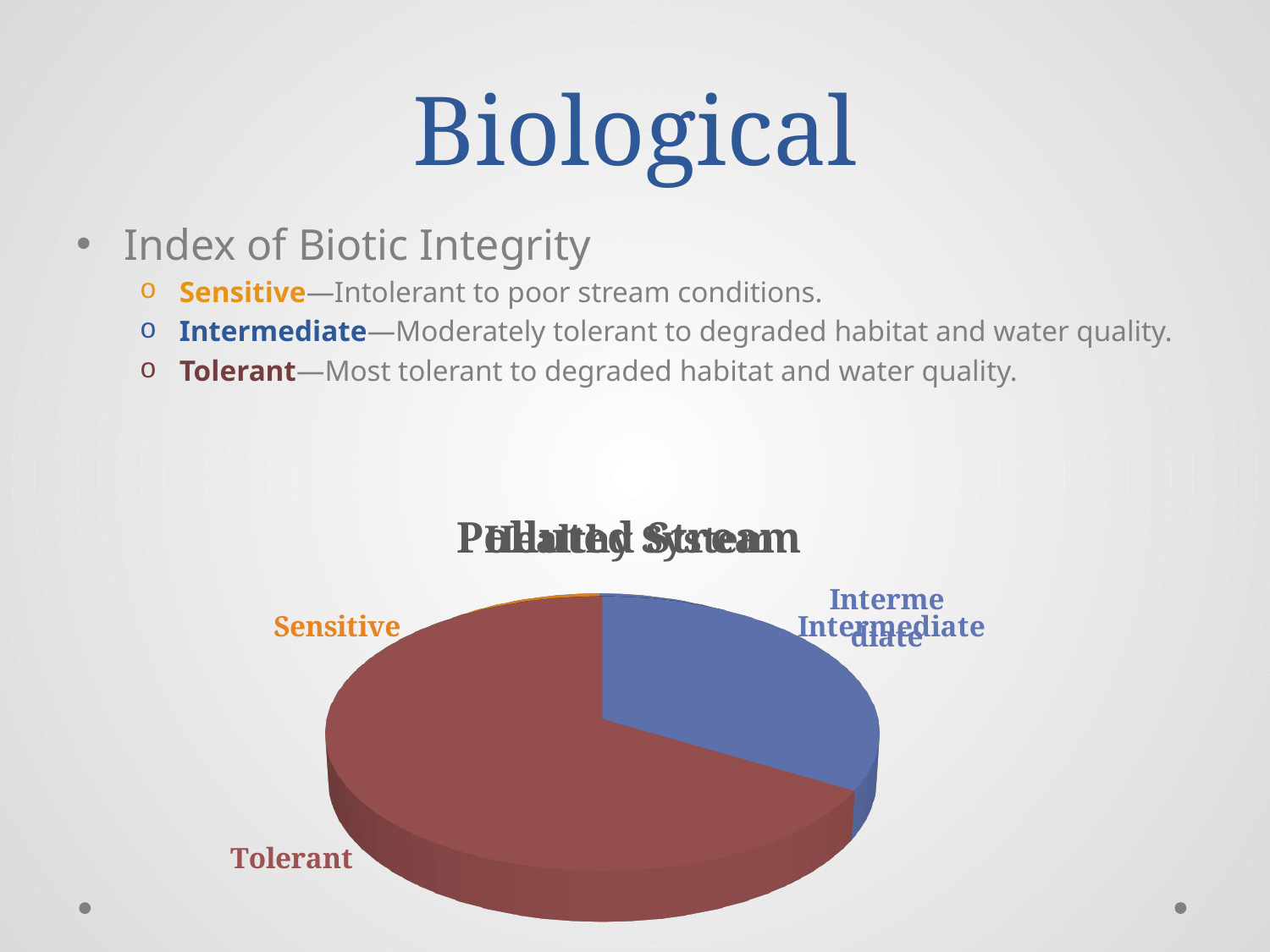
What kind of chart is shown on the slide? pie chart What colour is the Intermediate slice in the pie chart? blue In the pie chart, which slice is larger, Tolerant or Intermediate? Tolerant Which category has the largest slice in the pie chart? Tolerant Does the Tolerant slice take up more or less than half of the pie chart? more What colour is the Tolerant slice in the pie chart? red